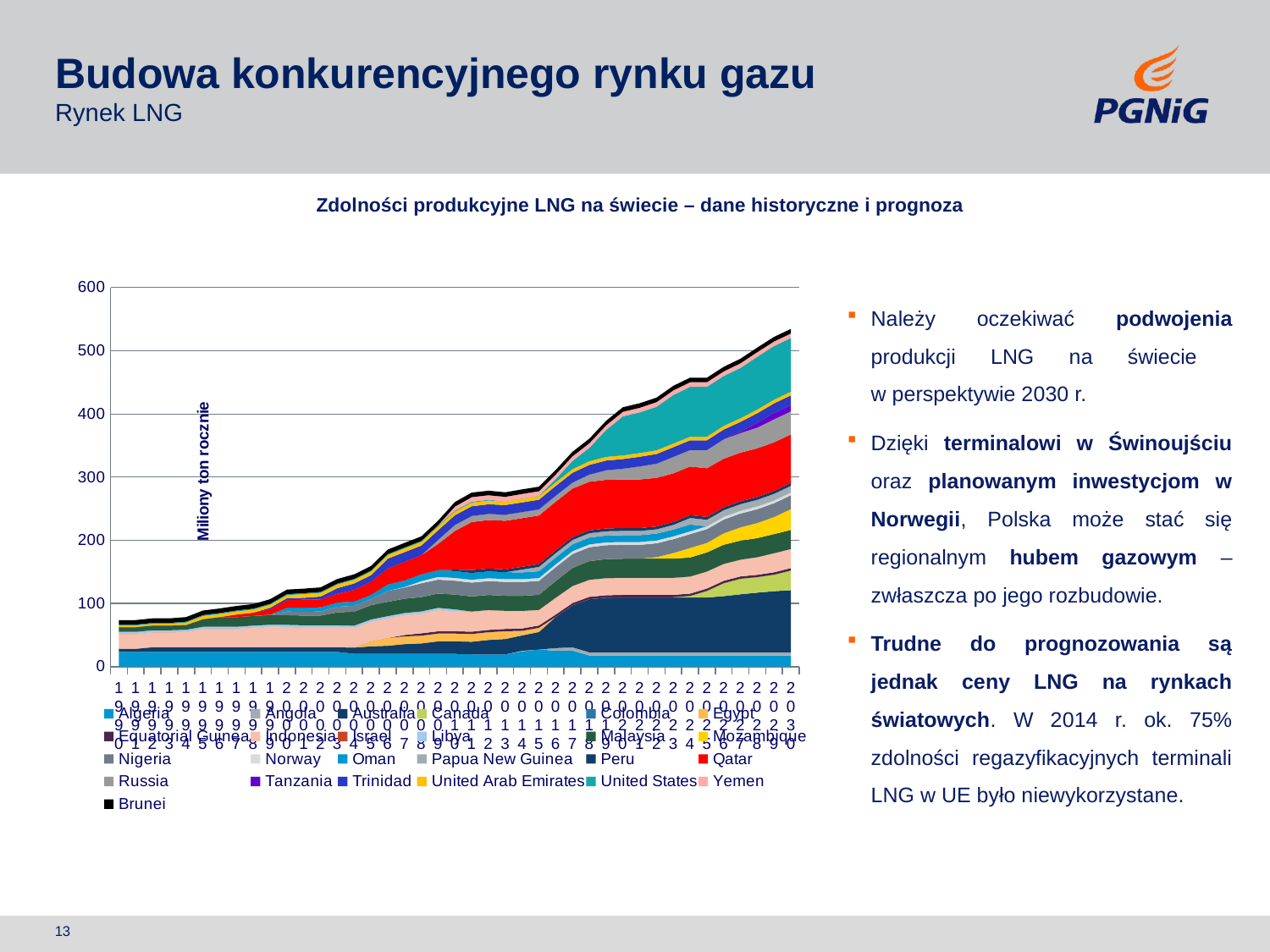
What is the highest value shown on the vertical axis of the chart? 600 What is the title of the chart? Zdolności produkcyjne LNG na świecie – dane historyczne i prognoza What is the label of the vertical axis of the chart? Miliony ton rocznie Does the total LNG production capacity rise or fall along the x axis from 1990 to 2030? Rises Which year is the first point on the x axis of the chart? 1990 What kind of chart is shown on the slide? Stacked area chart Is the total stacked value at the start of the series (1990) greater or less than 100? less How many series (countries) does the chart legend list? 25 Which year is the last point on the x axis of the chart? 2030 Is the total stacked value at the end of the series (2030) greater or less than 500? greater